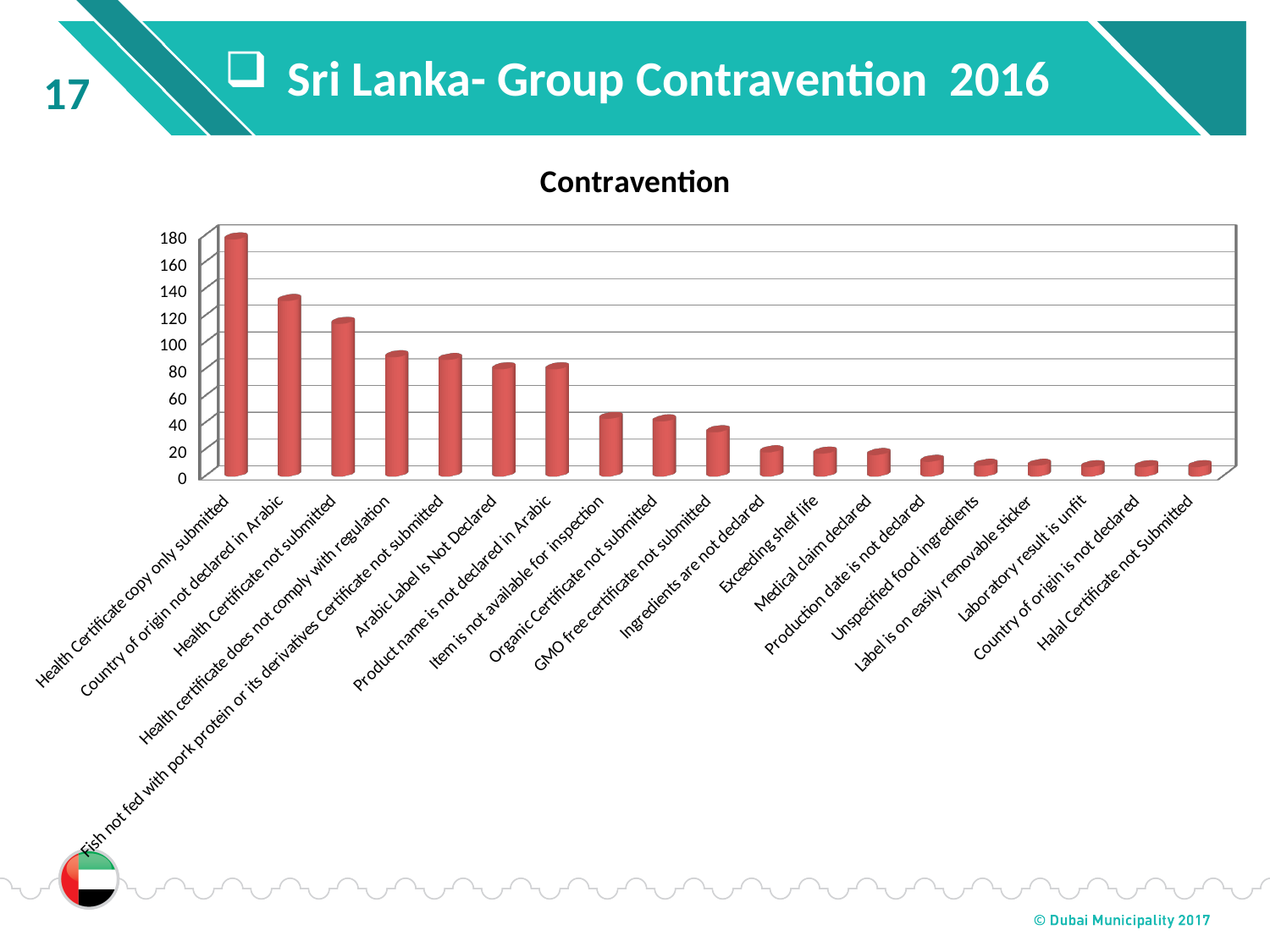
Is the value for 'Item is not available for inspection' greater or less than 60? less How many contravention categories are plotted in the chart? 19 Do the bar values generally rise or fall from left to right across the categories? fall Is the value for 'Halal Certificate not Submitted' greater or less than 20? less Is the value for 'GMO free certificate not submitted' greater or less than 20? greater Which is larger: the value for 'Health Certificate not submitted' or the value for 'Arabic Label Is Not Declared'? Health Certificate not submitted Which contravention category has the highest value? Health Certificate copy only submitted What is the title of the chart? Contravention What type of chart is shown on the slide? Bar chart